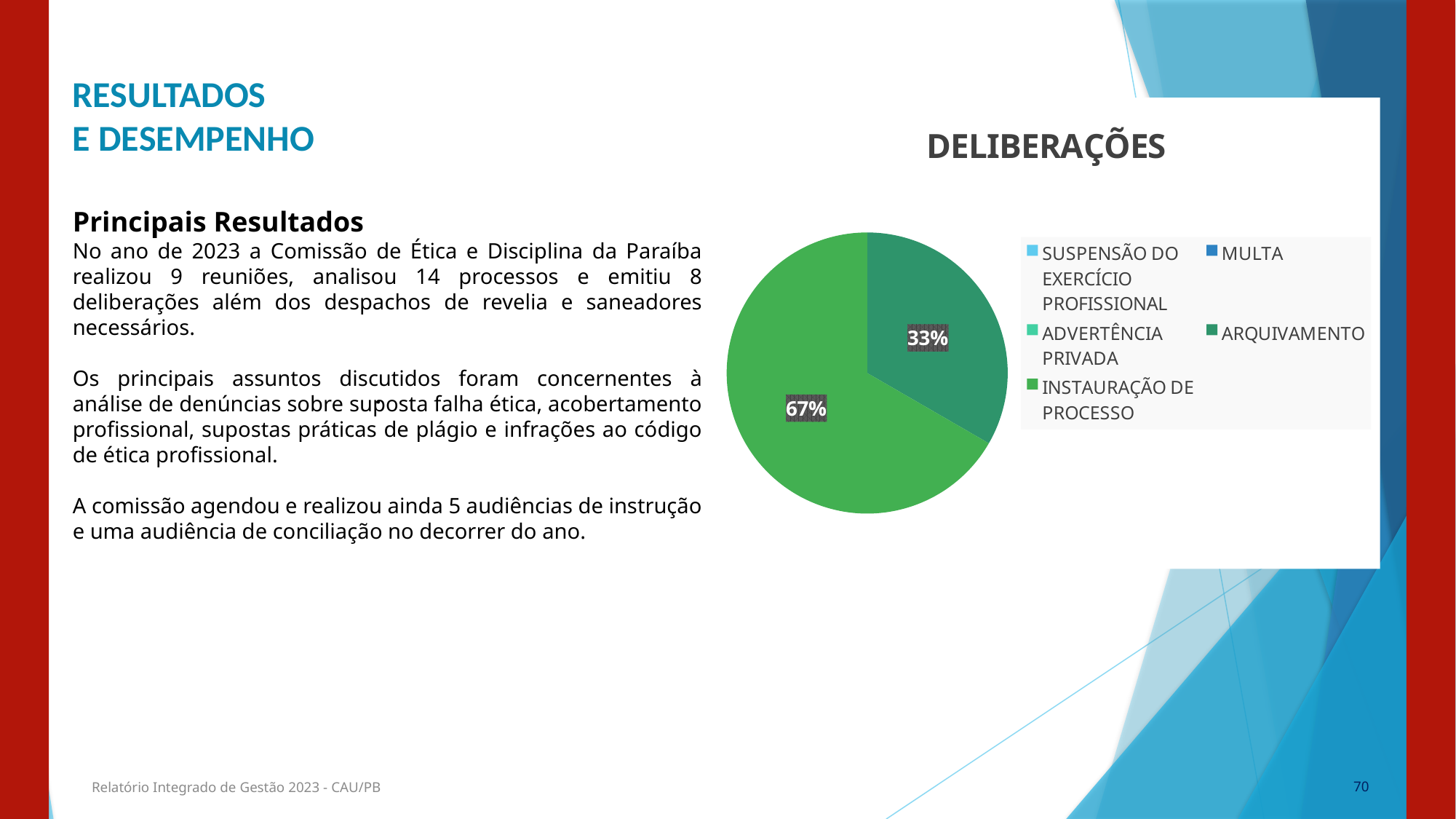
Which of the two visible slices is smaller, ARQUIVAMENTO or INSTAURAÇÃO DE PROCESSO? ARQUIVAMENTO What do the two labelled slices of the pie add up to? 100% How many slices with data labels are visible in the pie chart? 2 What share of the pie does INSTAURAÇÃO DE PROCESSO represent? 67% What is the title of the chart on the slide? DELIBERAÇÕES What kind of chart is shown under the title DELIBERAÇÕES? pie chart What is the difference in percentage points between the INSTAURAÇÃO DE PROCESSO slice and the ARQUIVAMENTO slice? 34 percentage points What share of the pie does ARQUIVAMENTO represent? 33% Is the slice for ARQUIVAMENTO larger or smaller than the slice for INSTAURAÇÃO DE PROCESSO? smaller Which category has the largest slice of the pie? INSTAURAÇÃO DE PROCESSO How many entries does the legend of the pie chart list? 5